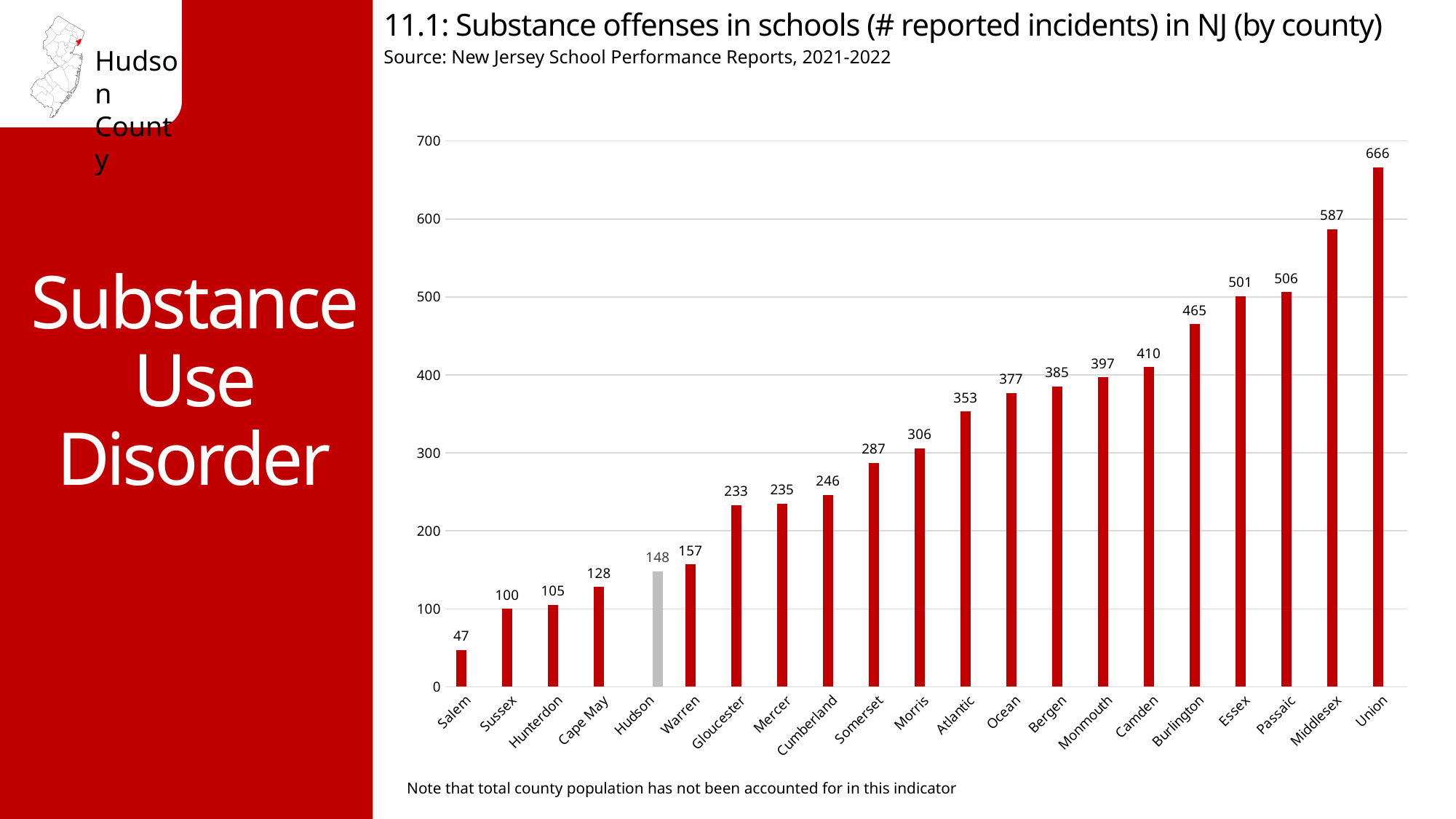
Which has more reported incidents, Bergen or Camden? Camden What is the number of reported substance offense incidents in schools for Hudson County? 148 What is the value shown for Gloucester? 233 Do the values rise or fall moving from left to right along the x axis? Rise Which county has the lowest number of reported incidents? Salem Is the value for Essex greater or less than 400? greater How many counties are shown on the chart? 21 What kind of chart is shown on the slide? Bar chart Which county has the highest number of reported incidents? Union Which bar is coloured grey instead of red? Hudson What is the difference between the values for Union and Hudson? 518 What is the value shown for Middlesex? 587